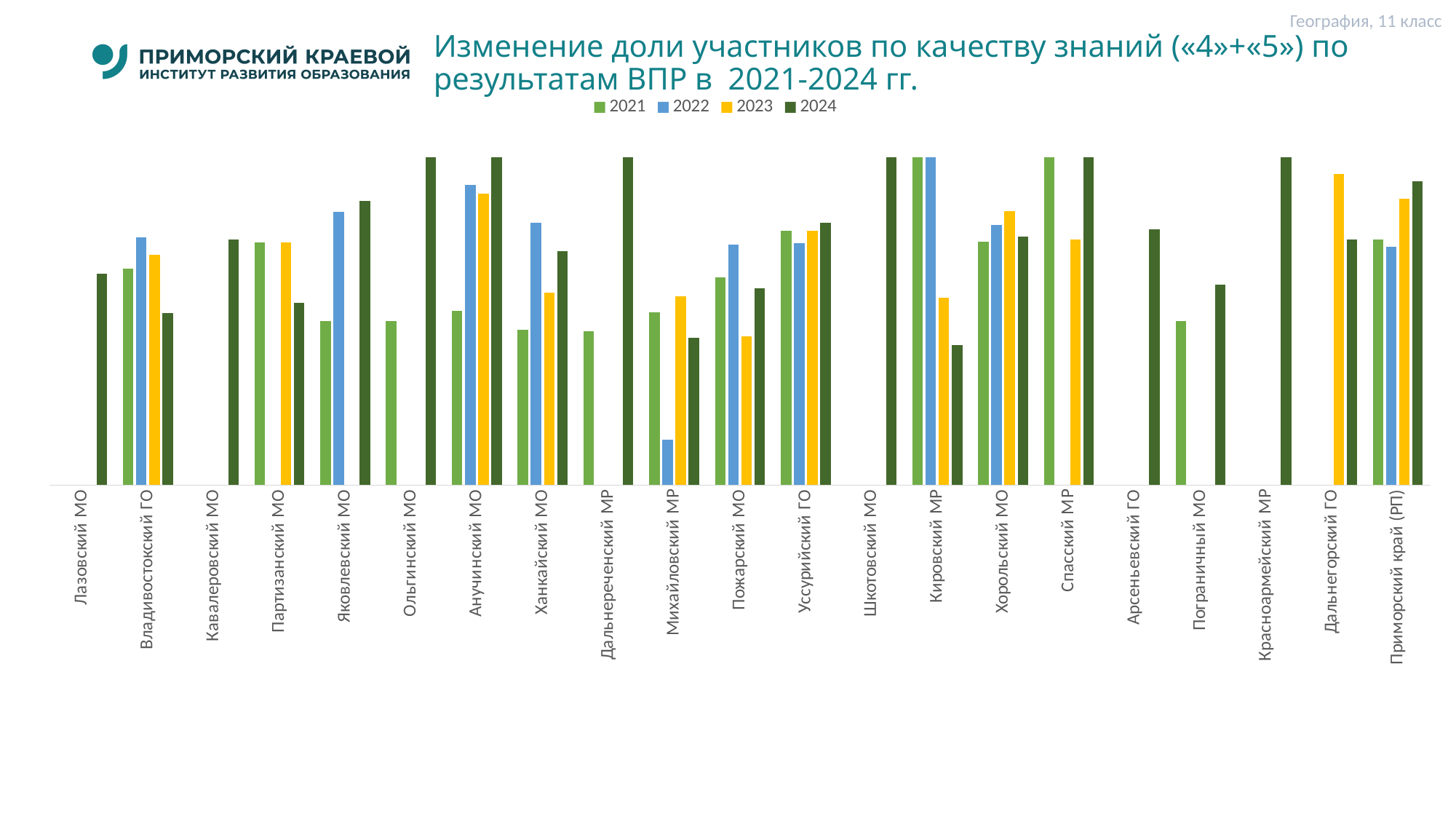
Which years are listed in the legend? 2021, 2022, 2023, 2024 For Кировский МР, which is larger: the 2021 value or the 2024 value? 2021 What subject and grade are indicated in the top right corner of the slide? География, 11 класс How many series does the legend list? 4 For Партизанский МО, which year has the lowest bar? 2024 For Михайловский МР, which year has the lowest bar? 2022 For Пожарский МО, which year has the highest bar? 2022 What kind of chart is shown on the slide? Bar chart For Анучинский МО, which is larger: the 2021 value or the 2022 value? 2022 For Ханкайский МО, which year has the highest bar? 2022 How many categories (territories) are shown along the x axis? 21 For Приморский край (РП), which is larger: the 2022 value or the 2023 value? 2023